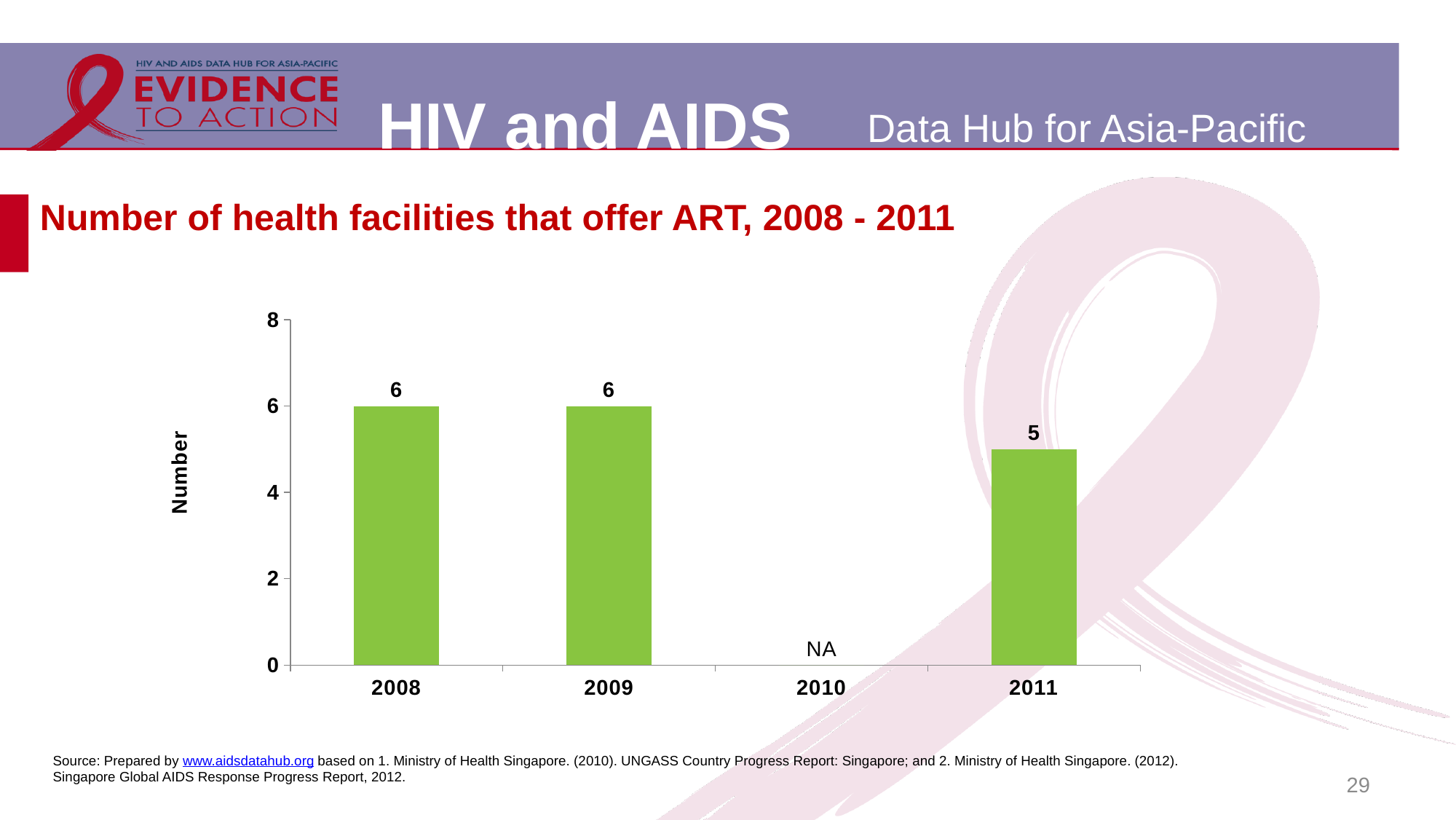
Is the value for 2011 greater or less than 4? greater How many years are shown on the x axis? 4 What kind of chart is shown on the slide? bar chart Which year has the lowest plotted value among the years with data? 2011 What is the number of health facilities that offer ART in 2008? 6 What is the number of health facilities that offer ART in 2011? 5 What is the difference between the value for 2009 and the value for 2011? 1 What is the title of the chart? Number of health facilities that offer ART, 2008 - 2011 Do the values rise or fall from 2009 to 2011? fall Which is larger, the value for 2008 or the value for 2011? 2008 What is the label of the y axis? Number What is shown for 2010 on the chart? NA